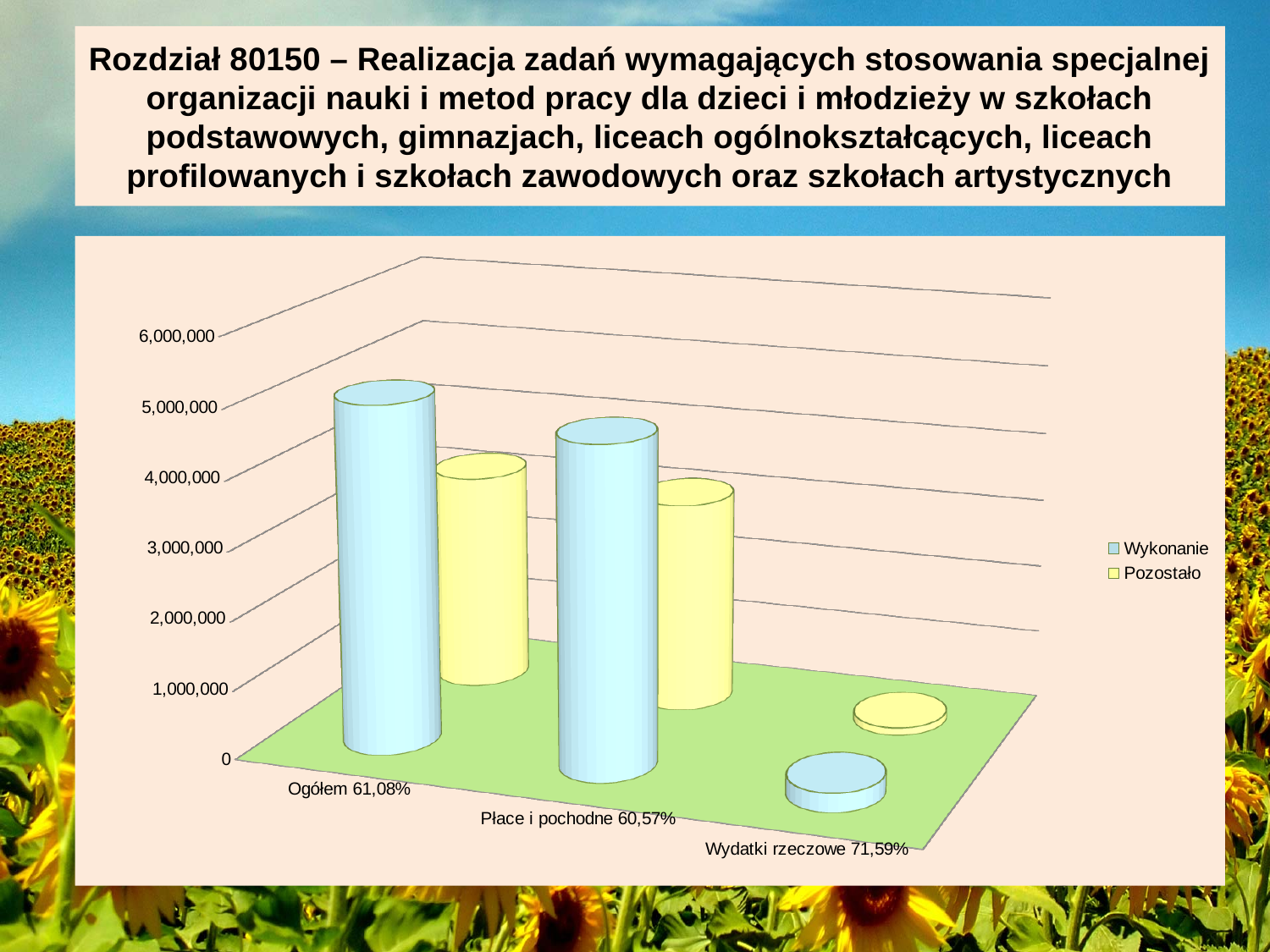
For Płace i pochodne, which is larger: Wykonanie or Pozostało? Wykonanie Is the Wykonanie value for Wydatki rzeczowe greater or less than 1,000,000? less Is the Wykonanie value for Ogółem greater or less than 3,000,000? greater Do the Wykonanie values rise or fall from Ogółem to Wydatki rzeczowe along the x axis? fall What are the two series named in the legend? Wykonanie and Pozostało What kind of chart is shown on the slide? bar chart What percentage is shown in the x-axis label for Wydatki rzeczowe? 71,59% How many series does the legend list? 2 How many categories are shown on the x axis? 3 Which category has the lowest Pozostało value? Wydatki rzeczowe What percentage is shown in the x-axis label for Ogółem? 61,08% Which category has the highest Wykonanie value? Ogółem